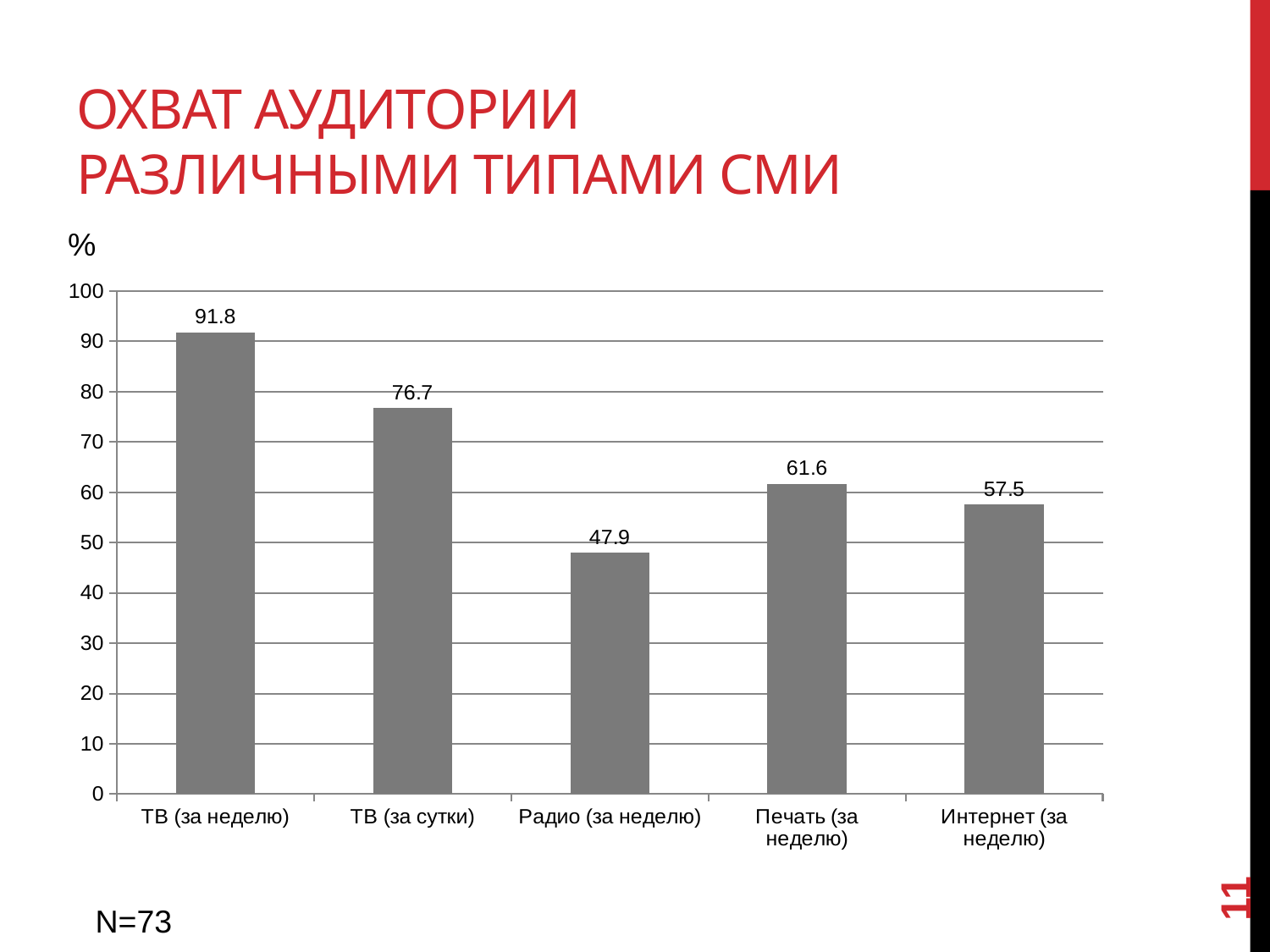
Which category has the lowest value? Радио (за неделю) What is the title of the slide containing the chart? ОХВАТ АУДИТОРИИ РАЗЛИЧНЫМИ ТИПАМИ СМИ What is the value for ТВ (за неделю)? 91.8 How many categories are shown on the chart? 5 What is the difference between the values for ТВ (за неделю) and ТВ (за сутки)? 15.1 Which is larger, the value for Печать (за неделю) or the value for Радио (за неделю)? Печать (за неделю) What kind of chart is shown on the slide? bar chart What is the value for Радио (за неделю)? 47.9 What is the difference between the values for Печать (за неделю) and Интернет (за неделю)? 4.1 Which category has the highest value? ТВ (за неделю) What is the value for Интернет (за неделю)? 57.5 Is the value for ТВ (за сутки) greater or less than 70? greater